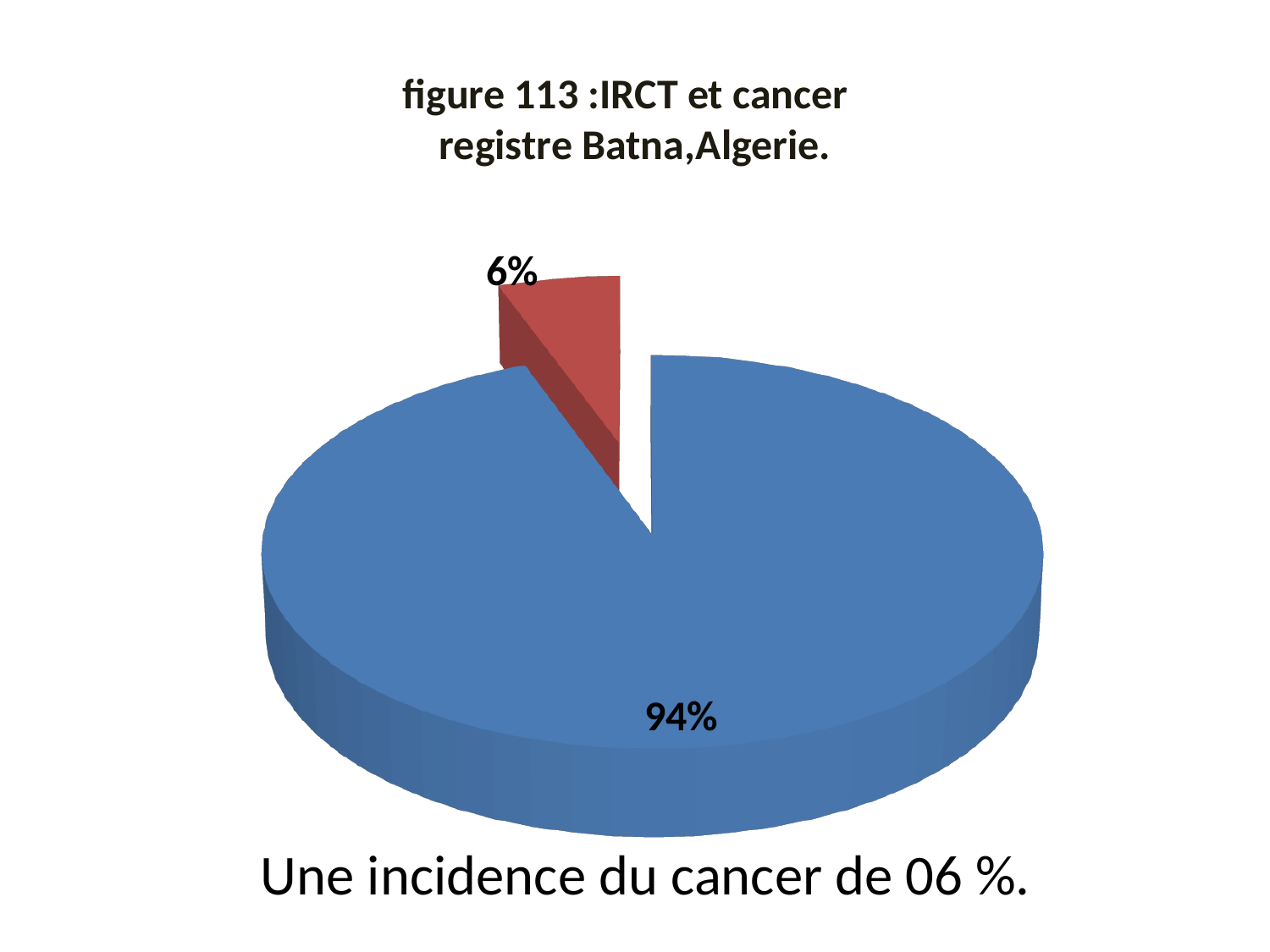
What is the total of the two percentages shown on the pie chart? 100% What share of the pie does the red slice represent? 6% What is the difference in percentage points between the blue slice and the red slice? 88 Which slice of the pie chart is the largest? the blue slice (94%) What share of the pie does the blue slice represent? 94% Which is larger, the red slice or the blue slice? the blue slice How many slices does the pie chart have? 2 What kind of chart is shown on the slide? pie chart Which slice of the pie chart is the smallest? the red slice (6%) What colour is the slice labelled 6%? red What is the title of the chart? figure 113 :IRCT et cancer registre Batna,Algerie.